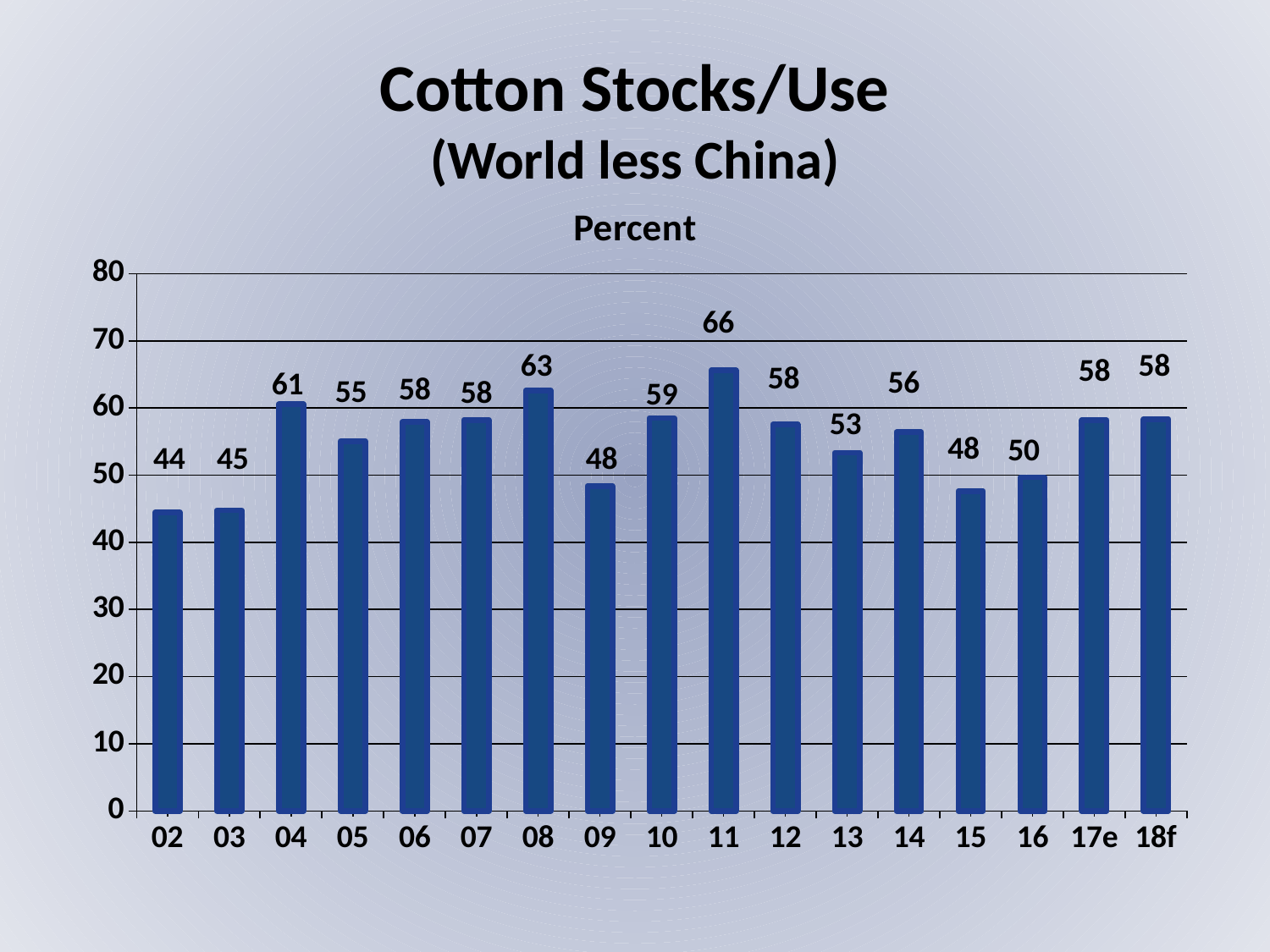
What is the cotton stocks/use value for 11? 66 How many years are shown on the x axis? 17 Is the value for 15 greater or less than 40? greater What kind of chart is shown on the slide? bar chart What is the difference between the values for 04 and 03? 16 Which is larger, the value for 13 or the value for 14? 14 Which year has the lowest stocks/use value? 02 What is the value shown for 02? 44 What is the value shown for 18f? 58 What is the difference between the values for 11 and 09? 18 What unit is indicated above the chart? Percent Which year has the highest stocks/use value? 11